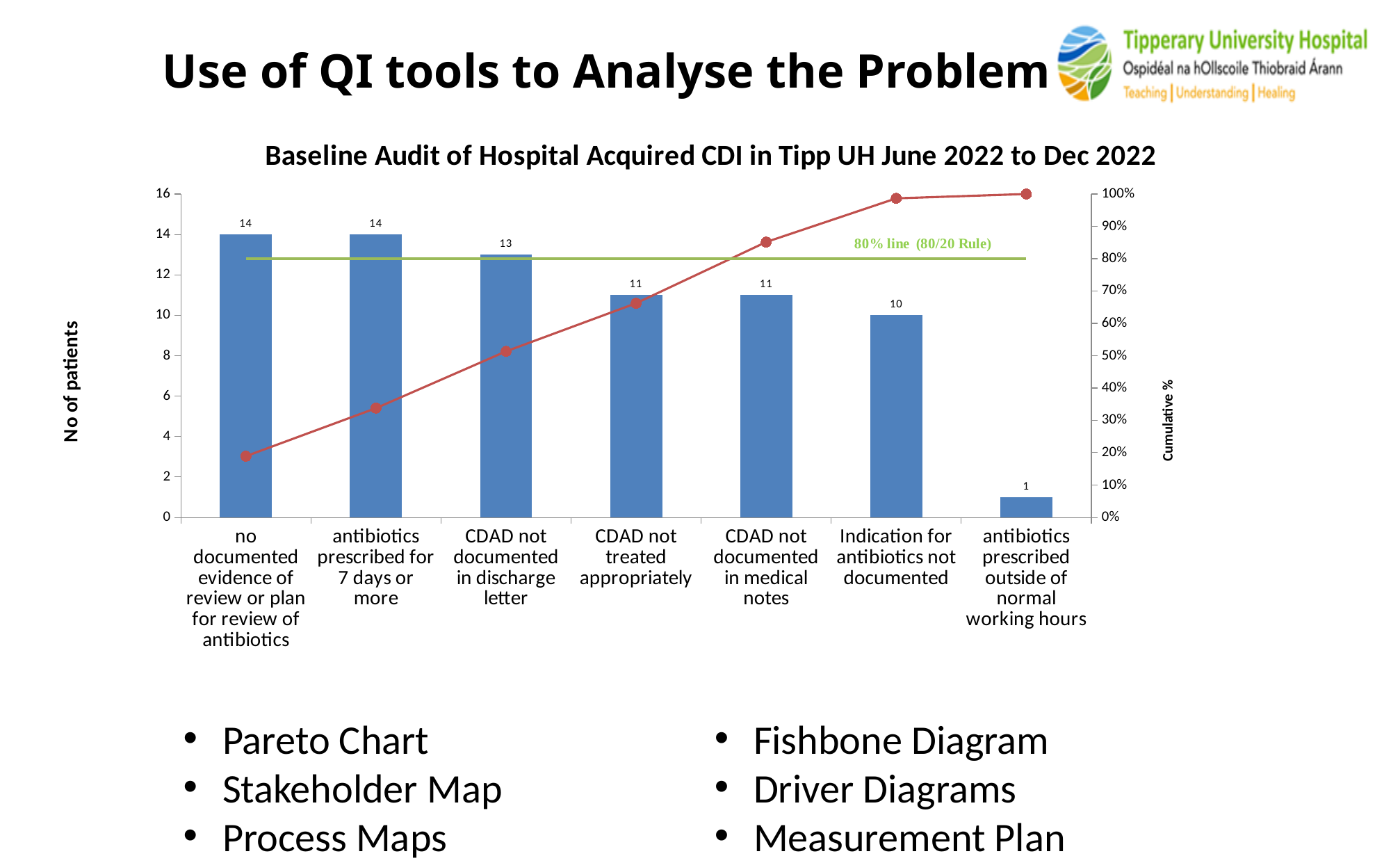
What is the number of patients for 'antibiotics prescribed outside of normal working hours'? 1 What is the number of patients for 'CDAD not documented in discharge letter'? 13 Do the bar values rise or fall from left to right along the x axis? fall What is the number of patients for 'Indication for antibiotics not documented'? 10 What is the difference in number of patients between 'CDAD not documented in discharge letter' and 'Indication for antibiotics not documented'? 3 What kind of chart is this? Pareto chart (bar chart with cumulative line) Which category has the lowest number of patients? antibiotics prescribed outside of normal working hours What is the title of the chart? Baseline Audit of Hospital Acquired CDI in Tipp UH June 2022 to Dec 2022 Is the cumulative % at 'CDAD not treated appropriately' greater or less than 70%? less Is the cumulative % at 'CDAD not documented in medical notes' greater or less than 80%? greater Which has more patients: 'CDAD not treated appropriately' or 'Indication for antibiotics not documented'? CDAD not treated appropriately How many categories are shown on the x axis? 7